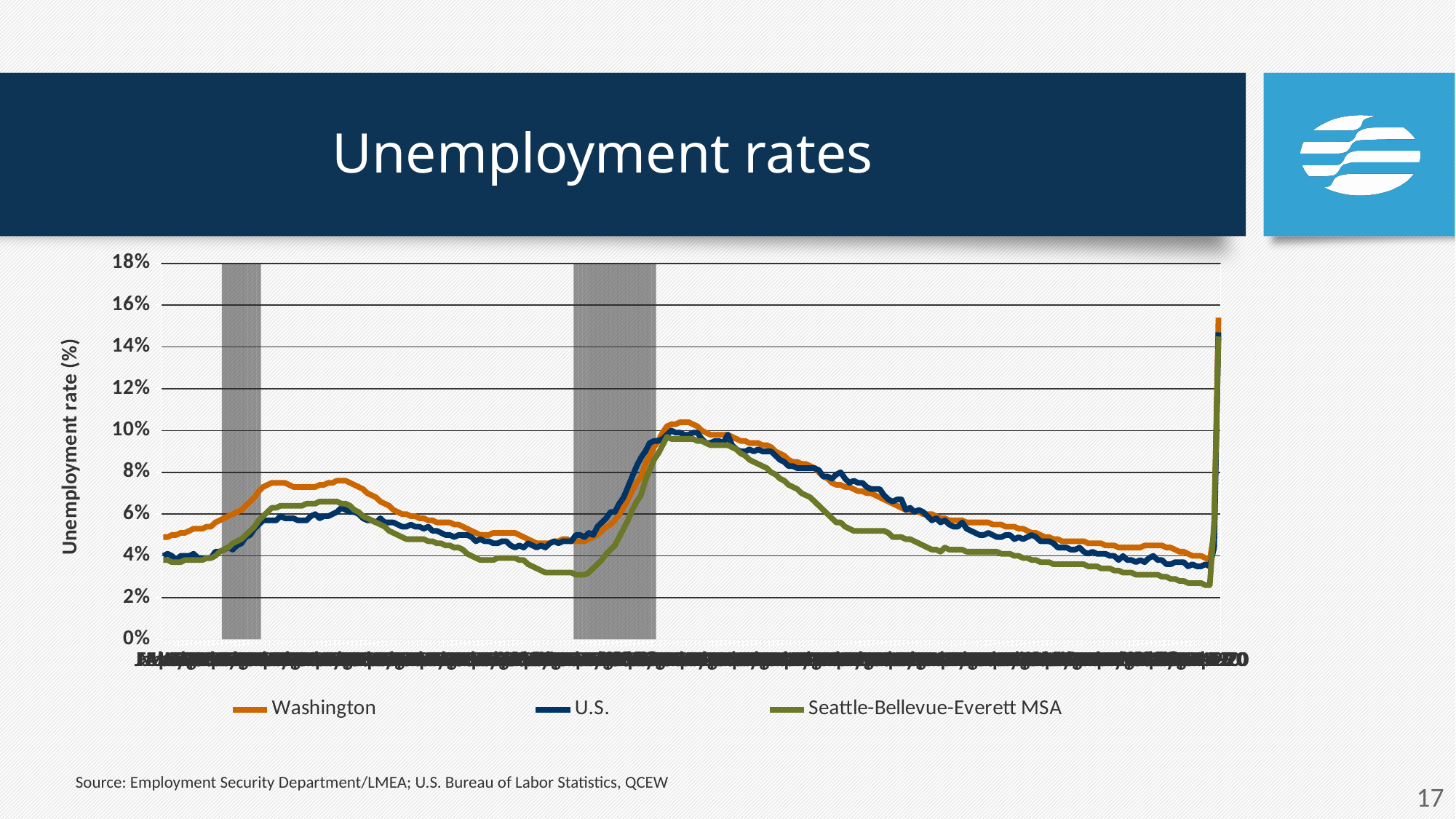
What kind of chart is shown on the slide? line chart Which series has the lowest value just before the final spike at the right edge of the chart? Seattle-Bellevue-Everett MSA Is the value reached by the lines in the final spike at the right edge of the chart greater or less than 12%? greater What is the label on the vertical axis? Unemployment rate (%) What is the highest value shown on the vertical axis? 18% What are the three series named in the legend? Washington, U.S., Seattle-Bellevue-Everett MSA Is the peak value of the Washington line near the second shaded band greater or less than 8%? greater Is the lowest value of the Seattle-Bellevue-Everett MSA line, just before the final spike at the right edge, greater or less than 4%? less From the peak after the second shaded band until just before the final spike at the right edge, do the lines rise or fall? fall How many series does the legend list? 3 At the peak just after the second shaded band, which is higher: the Washington line or the Seattle-Bellevue-Everett MSA line? Washington Just before the final spike at the right edge, which is higher: the Washington line or the Seattle-Bellevue-Everett MSA line? Washington